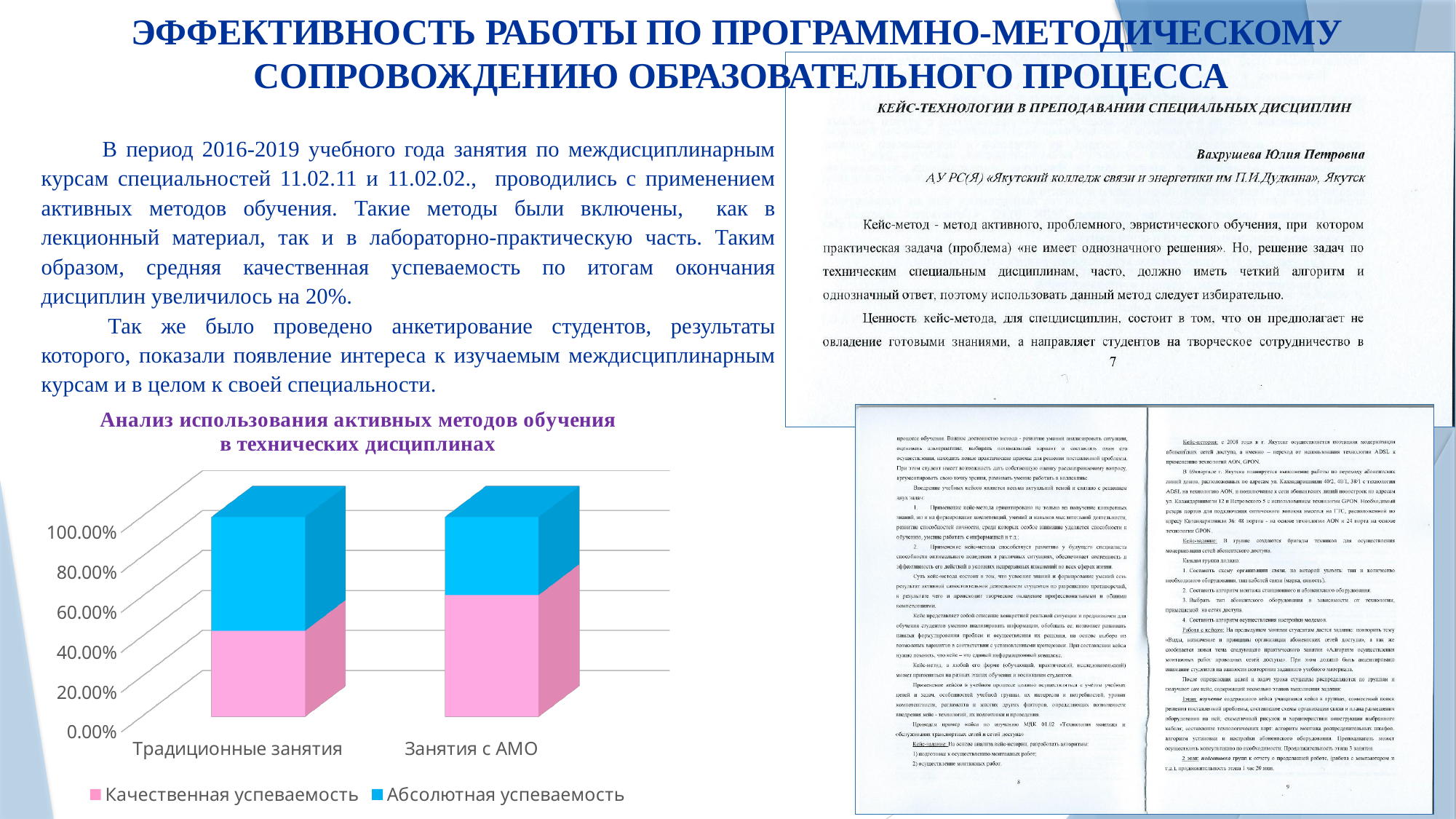
Is the value for Качественная успеваемость for Традиционные занятия greater or less than 60.00%? less How many series does the chart legend list? 2 Which category has the higher value for Качественная успеваемость: Традиционные занятия or Занятия с АМО? Занятия с АМО What is the title of the chart? Анализ использования активных методов обучения в технических дисциплинах Does the value for Качественная успеваемость rise or fall from Традиционные занятия to Занятия с АМО? rise Which series is shown in pink in the chart? Качественная успеваемость What kind of chart is shown on the slide? stacked bar chart Is the value for Качественная успеваемость for Занятия с АМО greater or less than 40.00%? greater Is the value for Качественная успеваемость for Традиционные занятия greater or less than 20.00%? greater How many categories are shown on the x axis of the chart? 2 Which category has the lowest value for Качественная успеваемость? Традиционные занятия